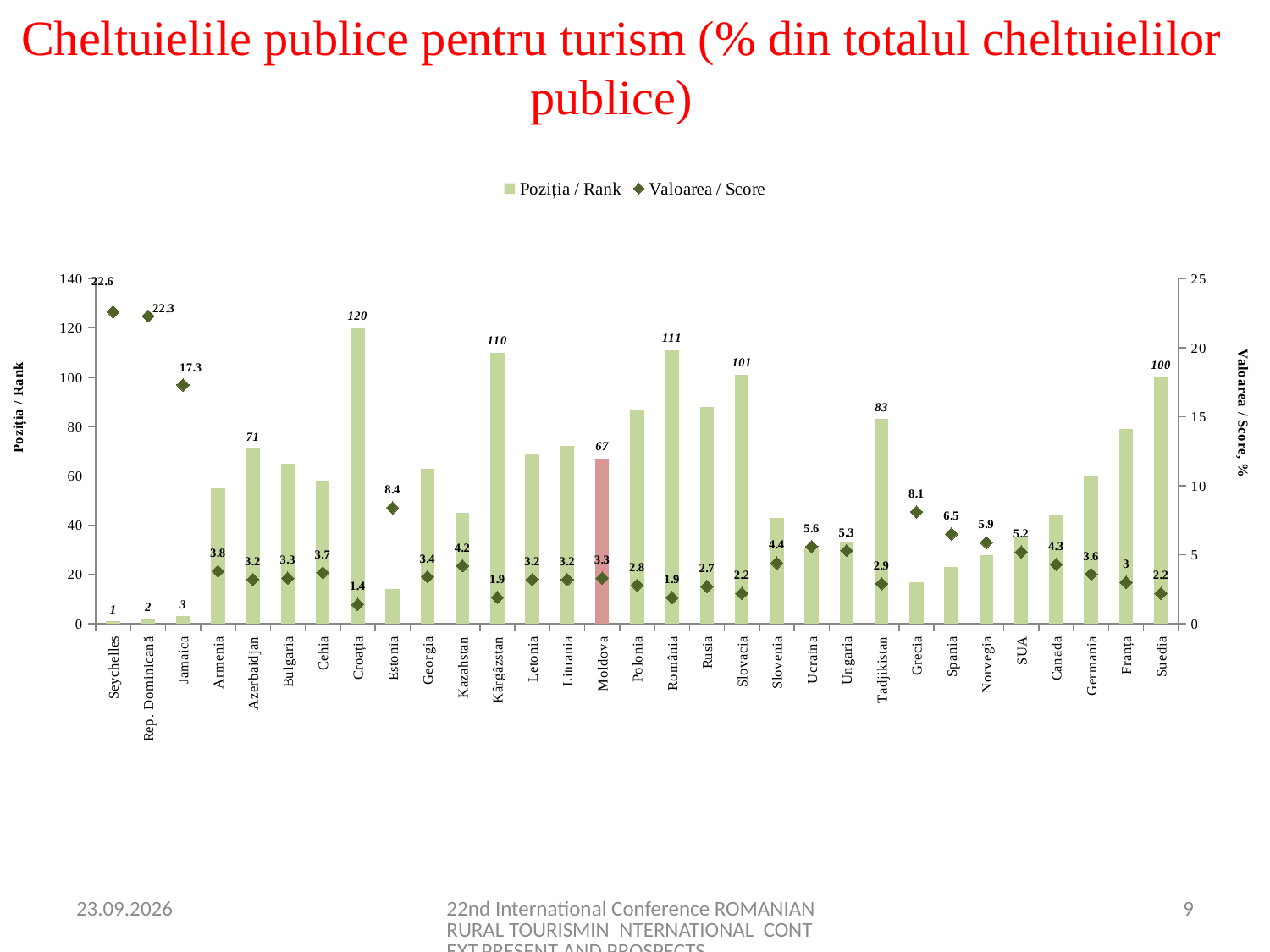
Which country has the highest Valoarea / Score? Seychelles What kind of chart is shown on the slide? bar chart (with score markers) How many series does the legend list? 2 What is the Valoarea / Score value for Croația? 1.4 Which has the larger Poziția / Rank value, Kârgâzstan or România? România What is the Poziția / Rank value for Moldova? 67 Which country's bar is highlighted in a different colour from the others? Moldova What is the difference between the Poziția / Rank values of Croația and Suedia? 20 Which country has the highest Poziția / Rank bar? Croația What is the Valoarea / Score value for Estonia? 8.4 Is the Poziția / Rank value for Estonia greater or less than 20? less How many countries are shown on the x axis? 31